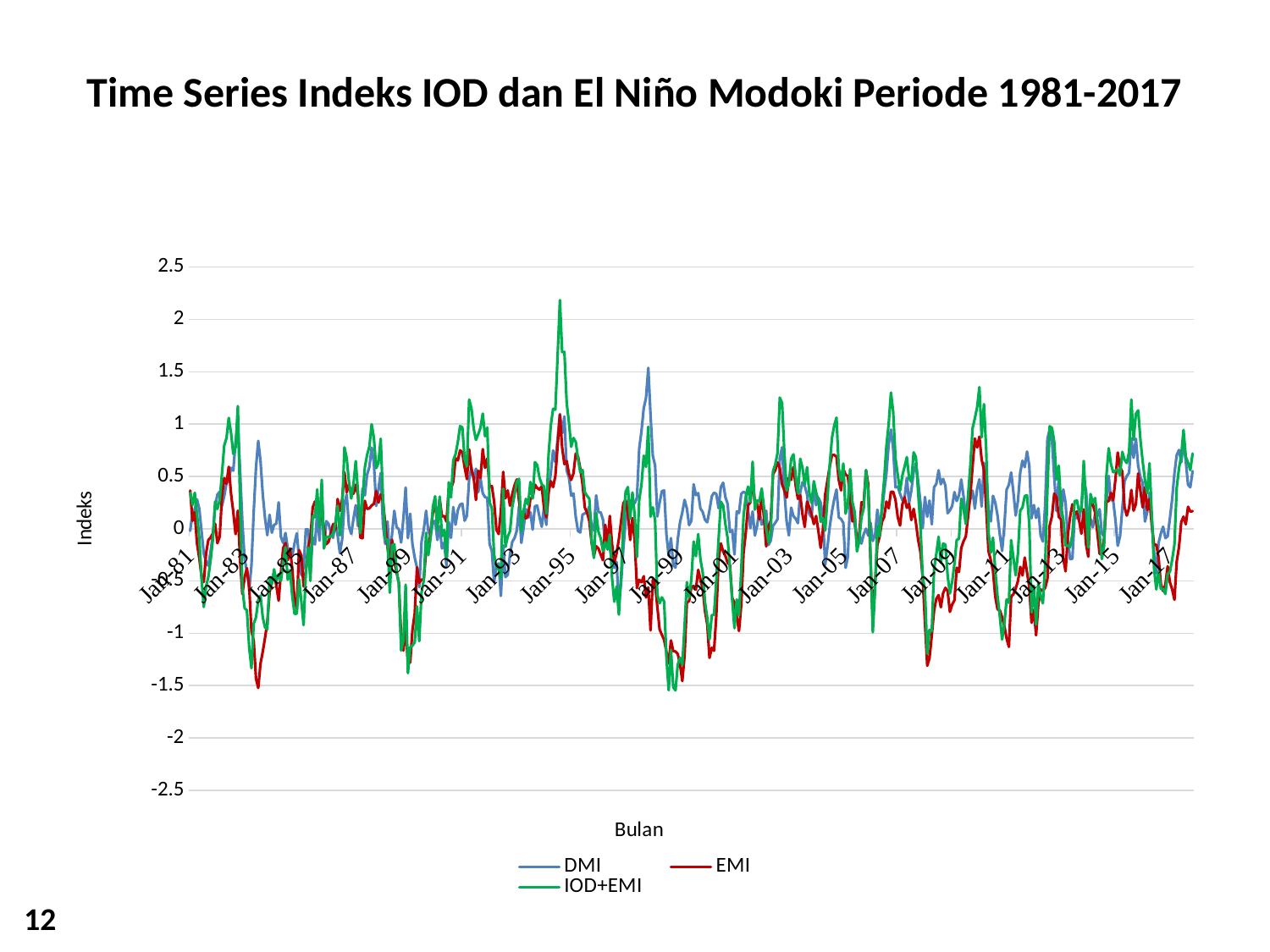
Which series is drawn in green? IOD+EMI Is the peak value of the DMI series around Jan-97 to Jan-99 greater or less than 1? greater What is the label of the vertical axis? Indeks What is the label of the horizontal axis? Bulan What is the highest value shown on the vertical axis? 2.5 Which series reaches the highest value on the chart? IOD+EMI What is the lowest value shown on the vertical axis? -2.5 How many series does the legend list? 3 What is the title of the chart? Time Series Indeks IOD dan El Niño Modoki Periode 1981-2017 Is the peak value of the IOD+EMI series around Jan-95 greater or less than 2? greater Is the lowest value of the EMI series around Jan-83 greater or less than -1? less What kind of chart is shown on the slide? line chart